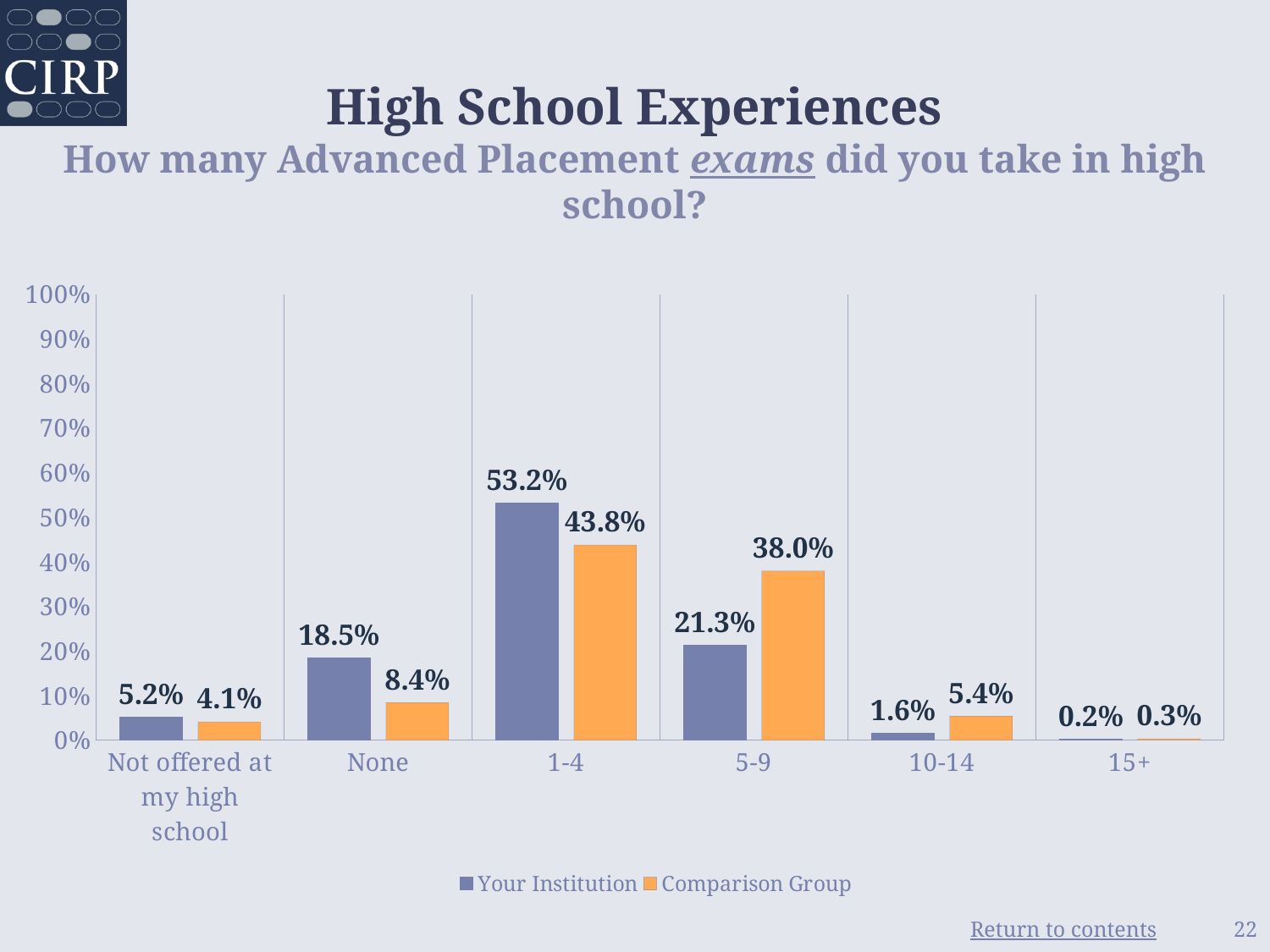
What is the difference between the Your Institution and Comparison Group values for the 1-4 category? 9.4% What kind of chart is shown on the slide? Bar chart For the 5-9 category, which series has the larger value, Your Institution or Comparison Group? Comparison Group Which category has the lowest value for Your Institution? 15+ How many series does the legend list? 2 What is the Comparison Group value for the 5-9 category? 38.0% What is the Your Institution value for the 'None' category? 18.5% Which category has the highest value for the Comparison Group? 1-4 What is the difference between the Comparison Group values for 'None' and '10-14'? 3.0% Is the Your Institution value for the 1-4 category greater or less than 50%? greater How many categories are shown on the x axis? 6 What percentage of Your Institution respondents took 1-4 Advanced Placement exams? 53.2%